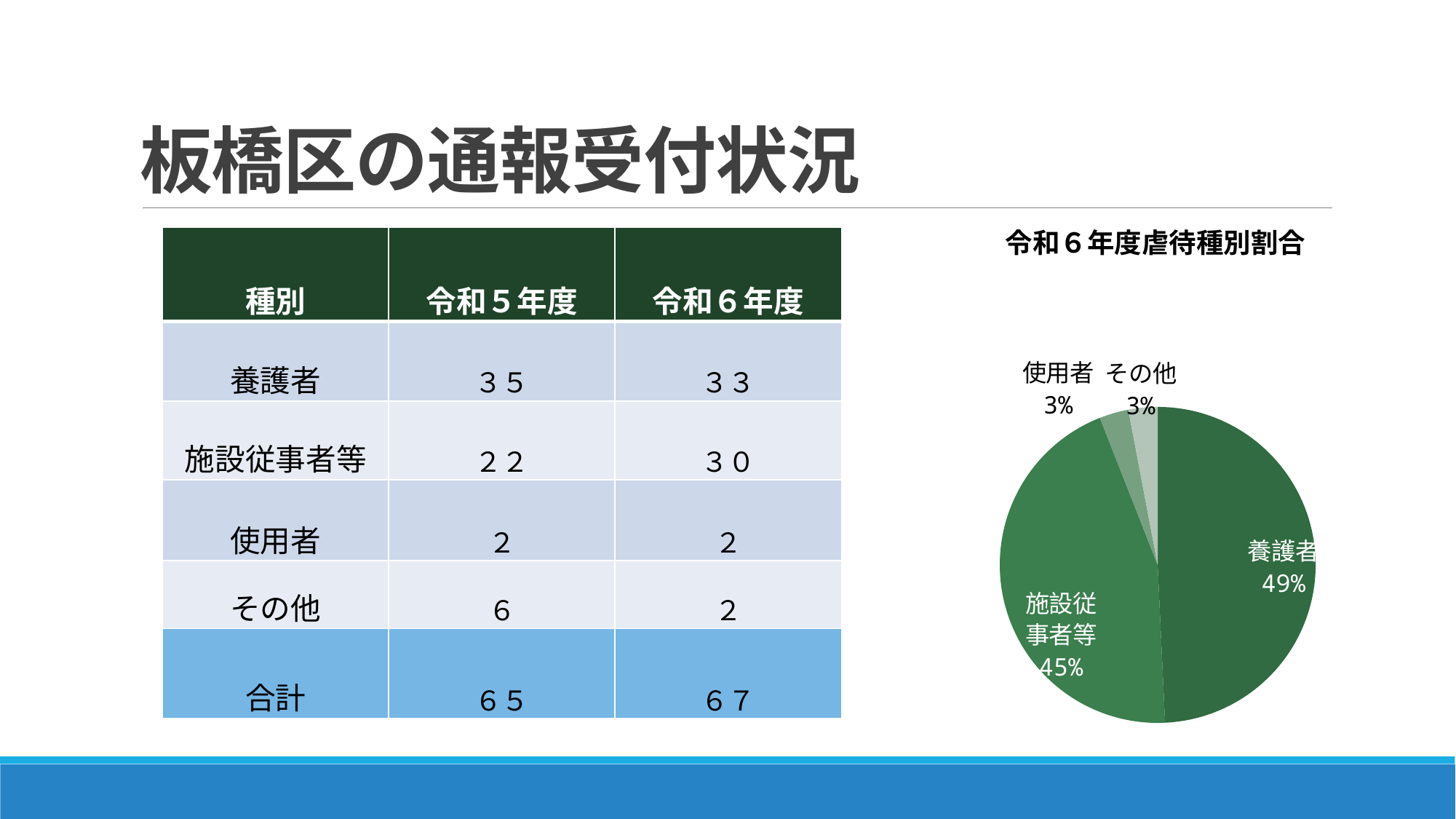
In the pie chart, what share does その他 have? 3% Which category has the largest slice in the pie chart? 養護者 How many slices does the pie chart have? 4 In the pie chart, what share does 使用者 have? 3% In the pie chart, which is larger: 施設従事者等 or その他? 施設従事者等 What type of chart is shown on the slide? pie chart In the pie chart, what is the difference in percentage points between 施設従事者等 and 使用者? 42 In the pie chart, what is the difference in percentage points between 養護者 and 施設従事者等? 4 In the pie chart, what share does 養護者 have? 49% In the pie chart, what share does 施設従事者等 have? 45% What is the title of the pie chart? 令和６年度虐待種別割合 In the pie chart, which is larger: 養護者 or 施設従事者等? 養護者